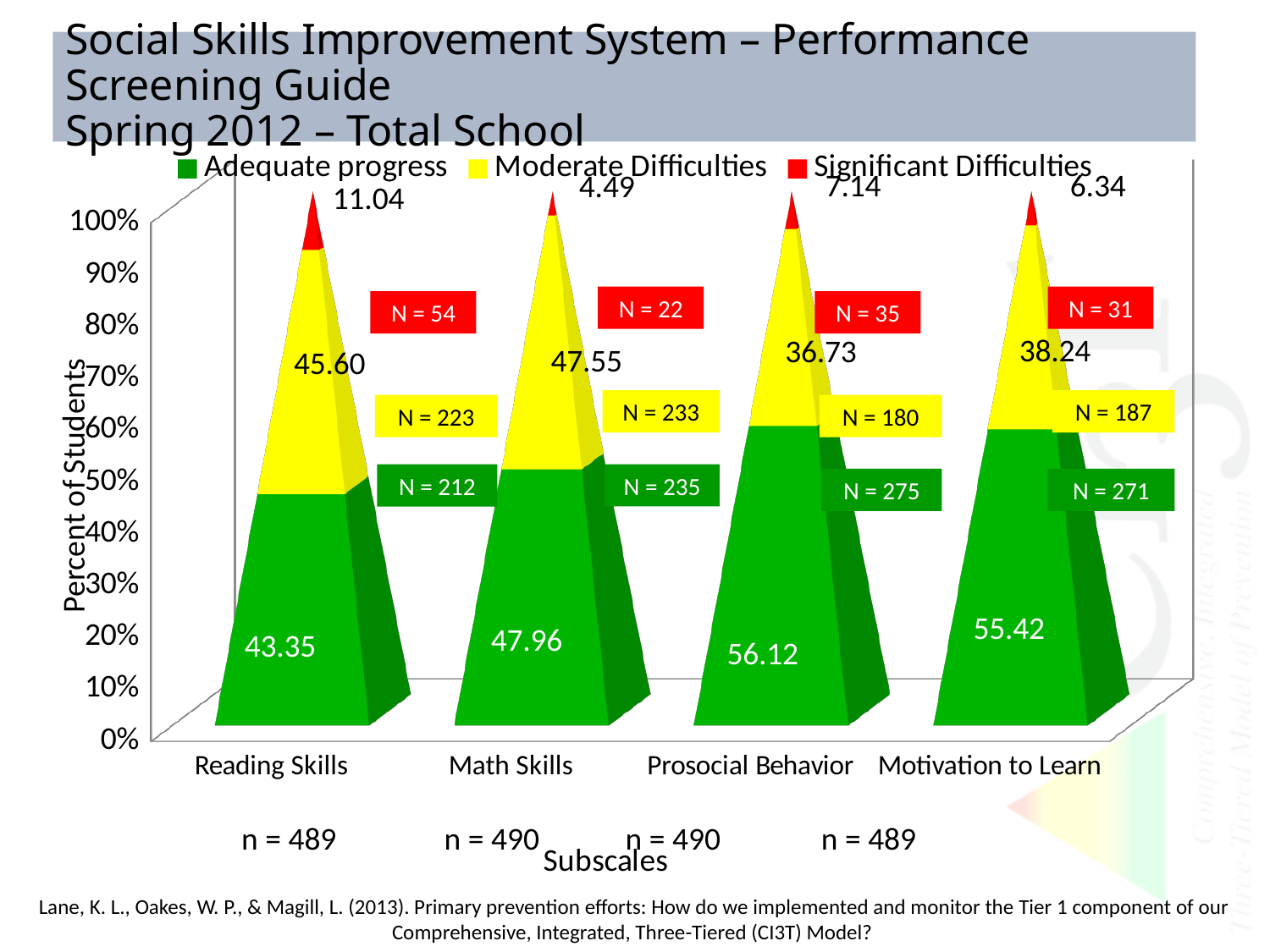
What is the Adequate progress value for Prosocial Behavior? 56.12 Which subscale has the lowest Adequate progress value? Reading Skills What is the Moderate Difficulties value for Math Skills? 47.55 How many subscales are shown on the x axis? 4 What is the Adequate progress value for Motivation to Learn? 55.42 What kind of chart is shown? Stacked bar chart Which is larger, the Moderate Difficulties value for Reading Skills or for Motivation to Learn? Reading Skills What is the difference between the Adequate progress values for Prosocial Behavior and Reading Skills? 12.77 Which subscale has the highest Significant Difficulties value? Reading Skills What is the Significant Difficulties value for Reading Skills? 11.04 How many series does the legend list? 3 What is the label of the y axis? Percent of Students